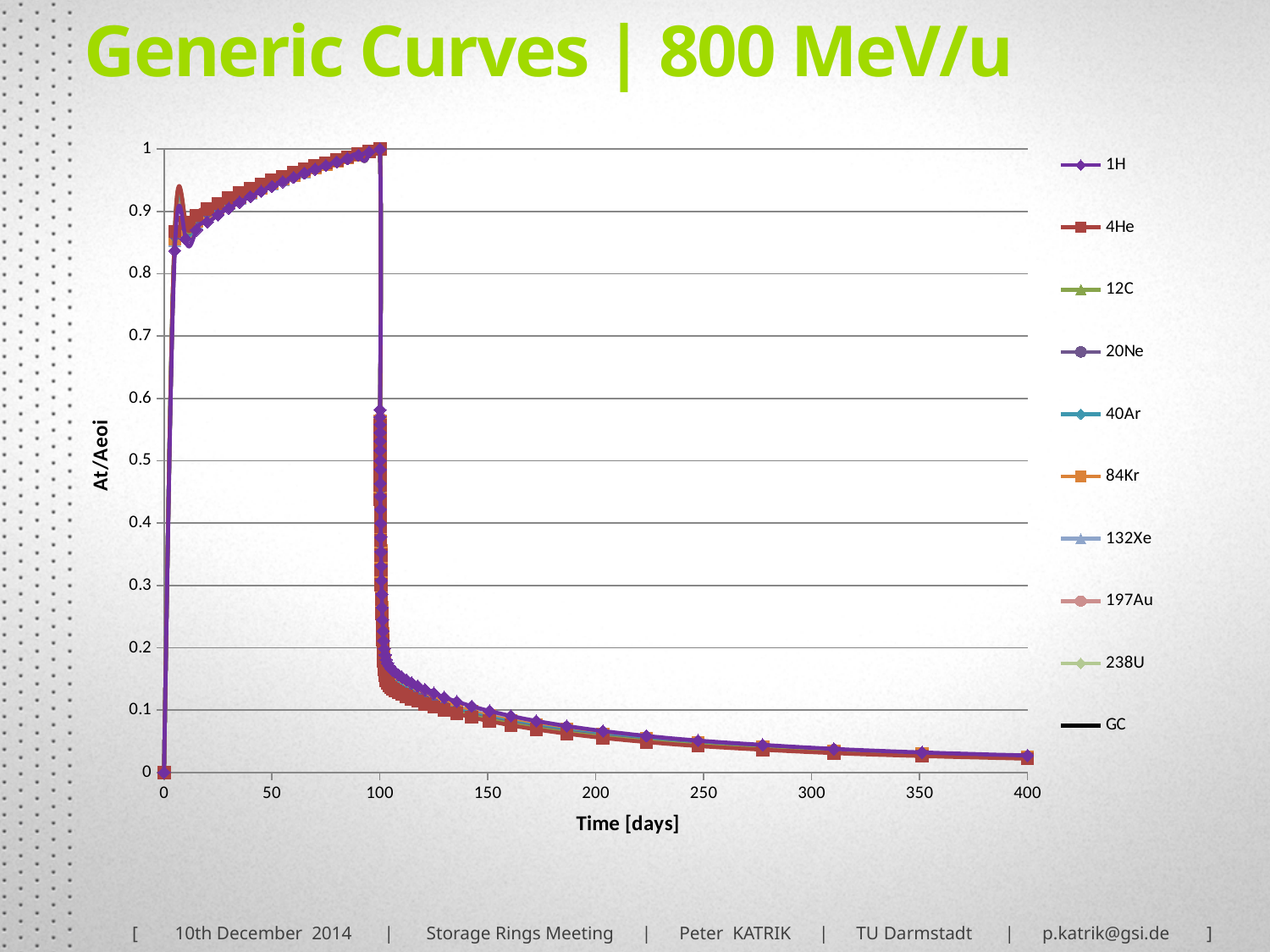
Is the value of the curves at 300 days greater or less than 0.2? less Is the value of the curves at 200 days greater or less than 0.1? less Do the curves rise or fall between 100 days and 400 days? fall Do the curves rise or fall between 20 days and 100 days? rise Is the value of the curves at 50 days greater or less than 0.8? greater How many series does the legend list? 10 What is the title of the chart on the slide? Generic Curves | 800 MeV/u What is the label of the x axis? Time [days] What kind of chart is shown on the slide? line chart What is the maximum value reached by the curves, at about 100 days? 1 What is the value of the curves at time 0 days? 0